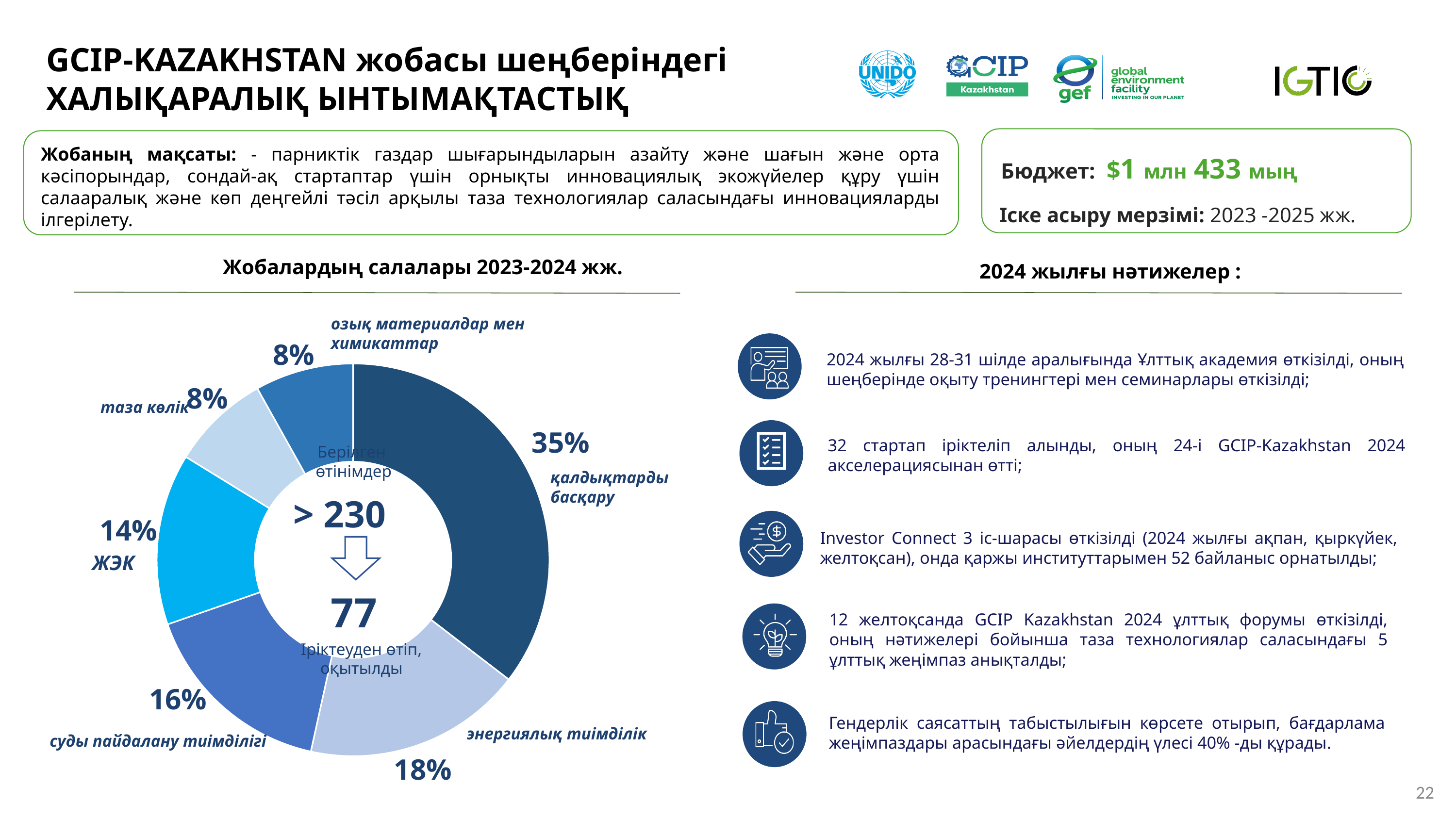
What number of submitted applications ("Берілген өтінімдер") is shown in the centre of the donut chart? > 230 How many sectors (slices) does the pie chart show? 6 What share of projects is in the "суды пайдалану тиімділігі" sector? 16% What share of projects is in the "таза көлік" sector? 8% What share of projects is in the "энергиялық тиімділік" sector? 18% What share of projects is in the "ЖЭК" sector? 14% What is the difference in share between "қалдықтарды басқару" and "энергиялық тиімділік"? 17% Which has a larger share: "ЖЭК" or "суды пайдалану тиімділігі"? суды пайдалану тиімділігі What is the combined share of "таза көлік" and "озық материалдар мен химикаттар"? 16% Which sector has the largest share in the pie chart? қалдықтарды басқару What share of projects is in the "қалдықтарды басқару" sector? 35% What kind of chart is shown under the title "Жобалардың салалары 2023-2024 жж."? Pie (donut) chart